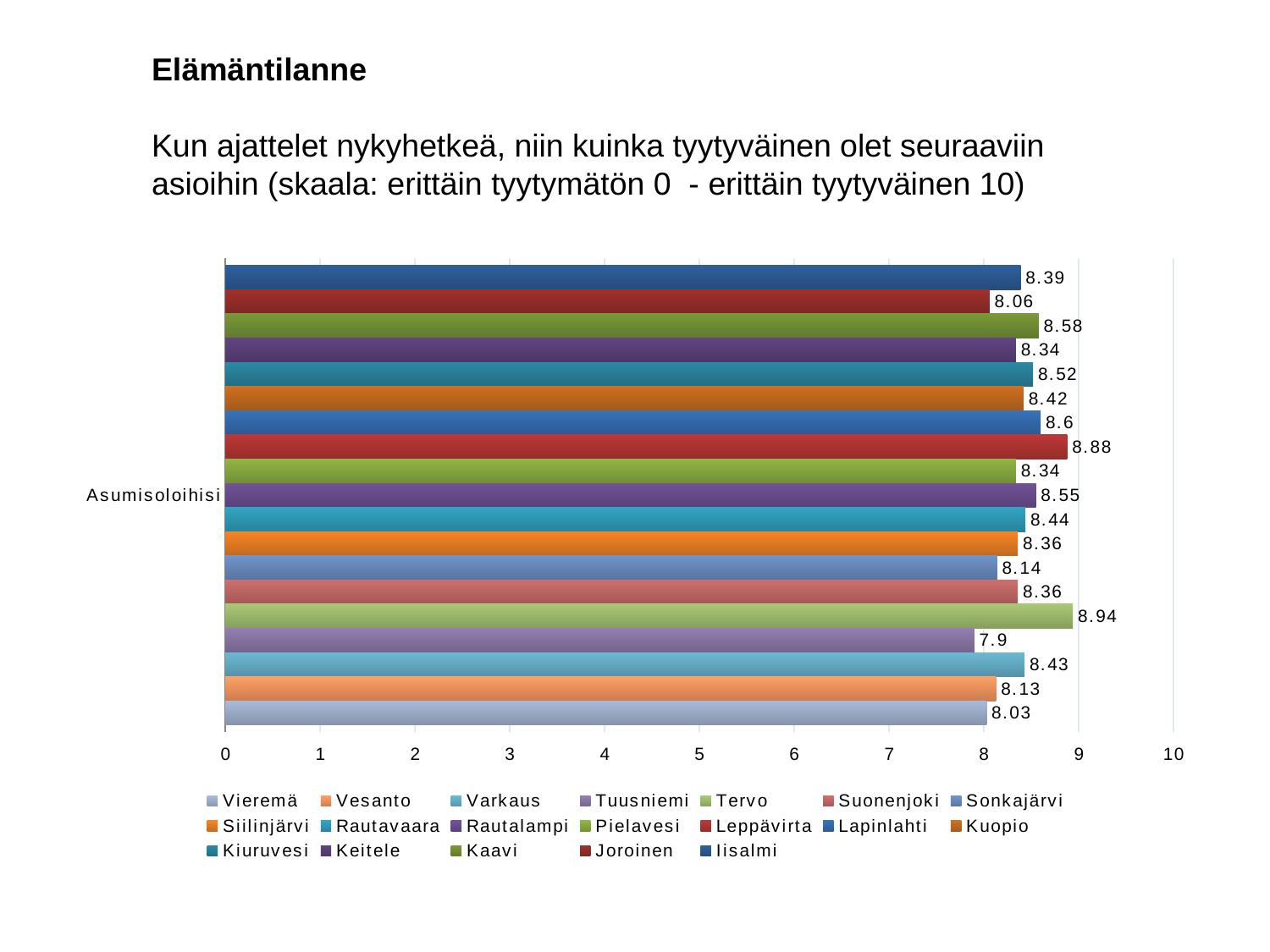
What is the value for Tervo? 8.94 What category label is shown on the vertical axis? Asumisoloihisi What is the value for Leppävirta? 8.88 How many series does the legend list? 19 Which municipality has the highest value for Asumisoloihisi? Tervo Is the value for Tuusniemi greater or less than 8? less Which municipality has the lowest value for Asumisoloihisi? Tuusniemi What is the value for Iisalmi? 8.39 What kind of chart is shown on the slide? bar chart Which has a larger value, Lapinlahti or Kuopio? Lapinlahti What is the value for Vieremä? 8.03 What is the difference between the values for Tervo and Tuusniemi? 1.04